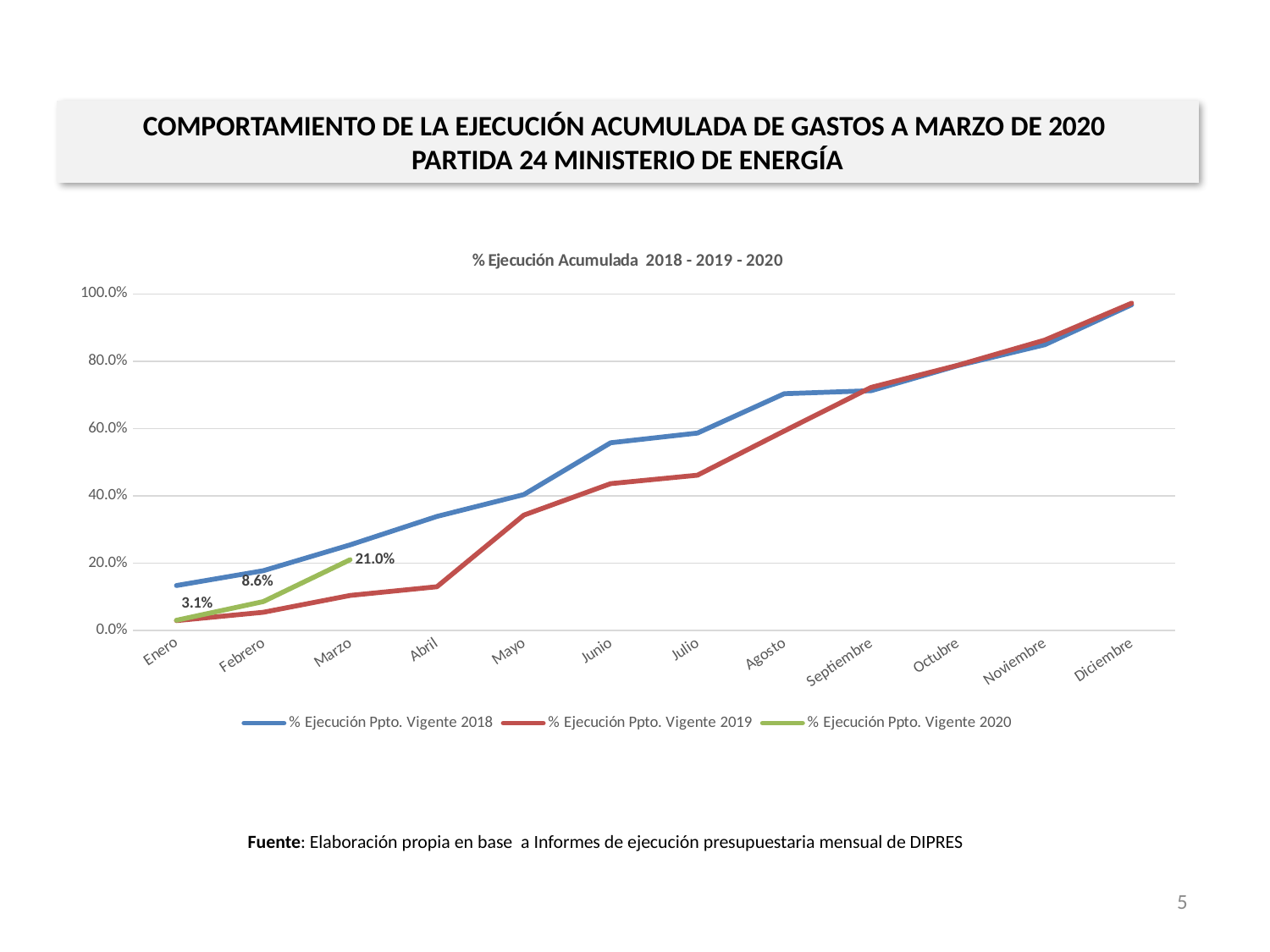
What kind of chart is shown on the slide? Line chart Does the % Ejecución Ppto. Vigente 2020 series rise or fall from Enero to Marzo? Rise What is the value for Enero in the % Ejecución Ppto. Vigente 2020 series? 3.1% Is the value for Abril in the % Ejecución Ppto. Vigente 2019 series greater or less than 20.0%? less How many months are shown on the x axis of the chart? 12 What is the value for Febrero in the % Ejecución Ppto. Vigente 2020 series? 8.6% Is the value for Agosto in the % Ejecución Ppto. Vigente 2018 series greater or less than 60.0%? greater What is the difference between the Marzo and Febrero values of the % Ejecución Ppto. Vigente 2020 series? 12.4% In Junio, which series has the larger value: % Ejecución Ppto. Vigente 2018 or % Ejecución Ppto. Vigente 2019? % Ejecución Ppto. Vigente 2018 How many series does the chart legend list? 3 What is the difference between the Febrero and Enero values of the % Ejecución Ppto. Vigente 2020 series? 5.5% What is the value for Marzo in the % Ejecución Ppto. Vigente 2020 series? 21.0%